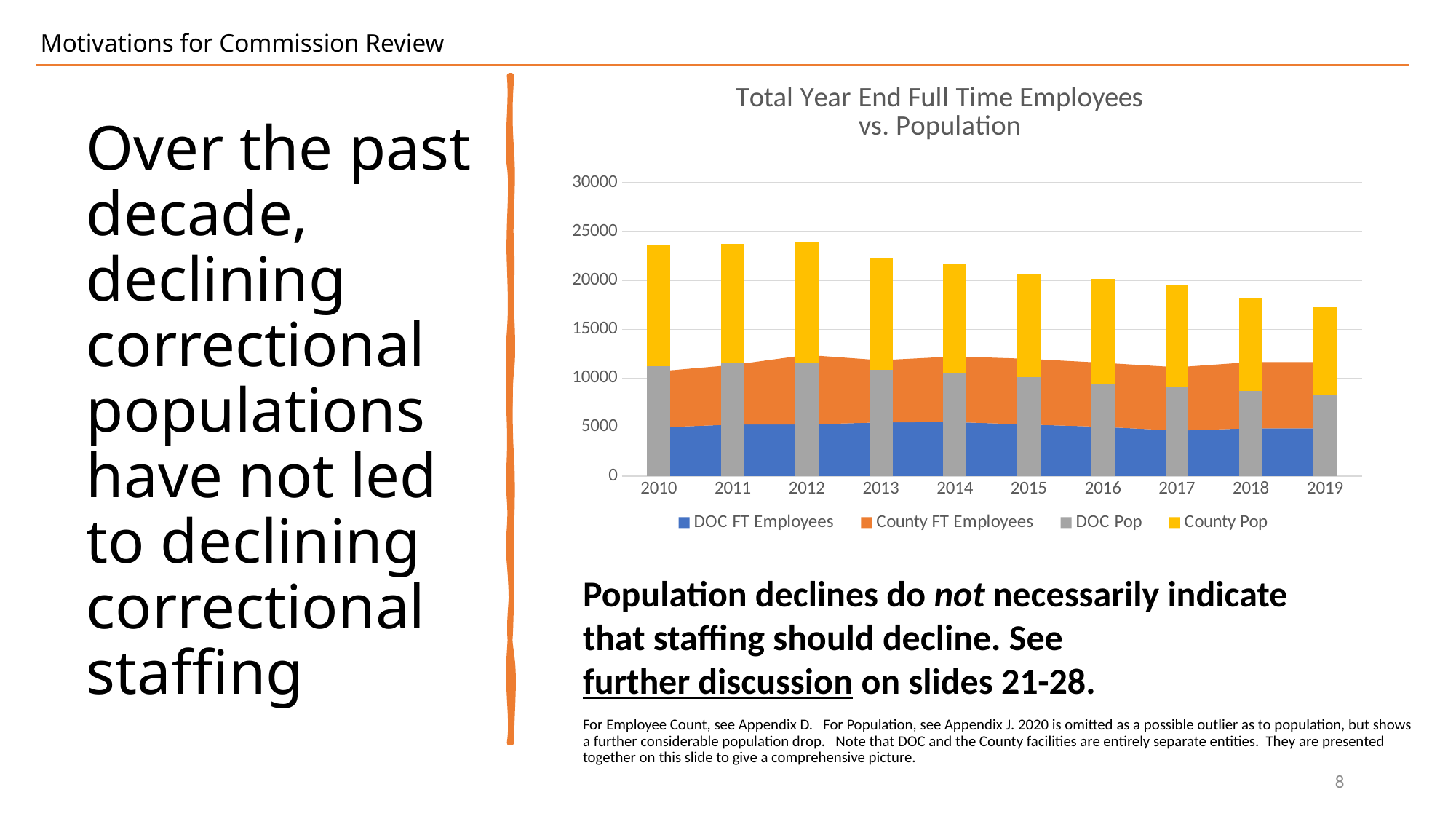
What kind of chart is shown on the slide? Combination of stacked bar and stacked area chart Is the DOC Pop value for 2010 greater or less than 10000? greater Which colour represents County Pop in the chart? Yellow How many years are shown on the x axis of the chart? 10 How many series does the chart legend list? 4 Which is larger, the total stacked bar for 2010 or for 2019? 2010 Is the total stacked bar for 2018 greater or less than 20000? less Is the total stacked bar for 2010 greater or less than 20000? greater What is the title of the chart? Total Year End Full Time Employees vs. Population Which year has the lowest total stacked bar (DOC Pop plus County Pop)? 2019 Do the total stacked bars (population) generally rise or fall from 2010 to 2019? fall